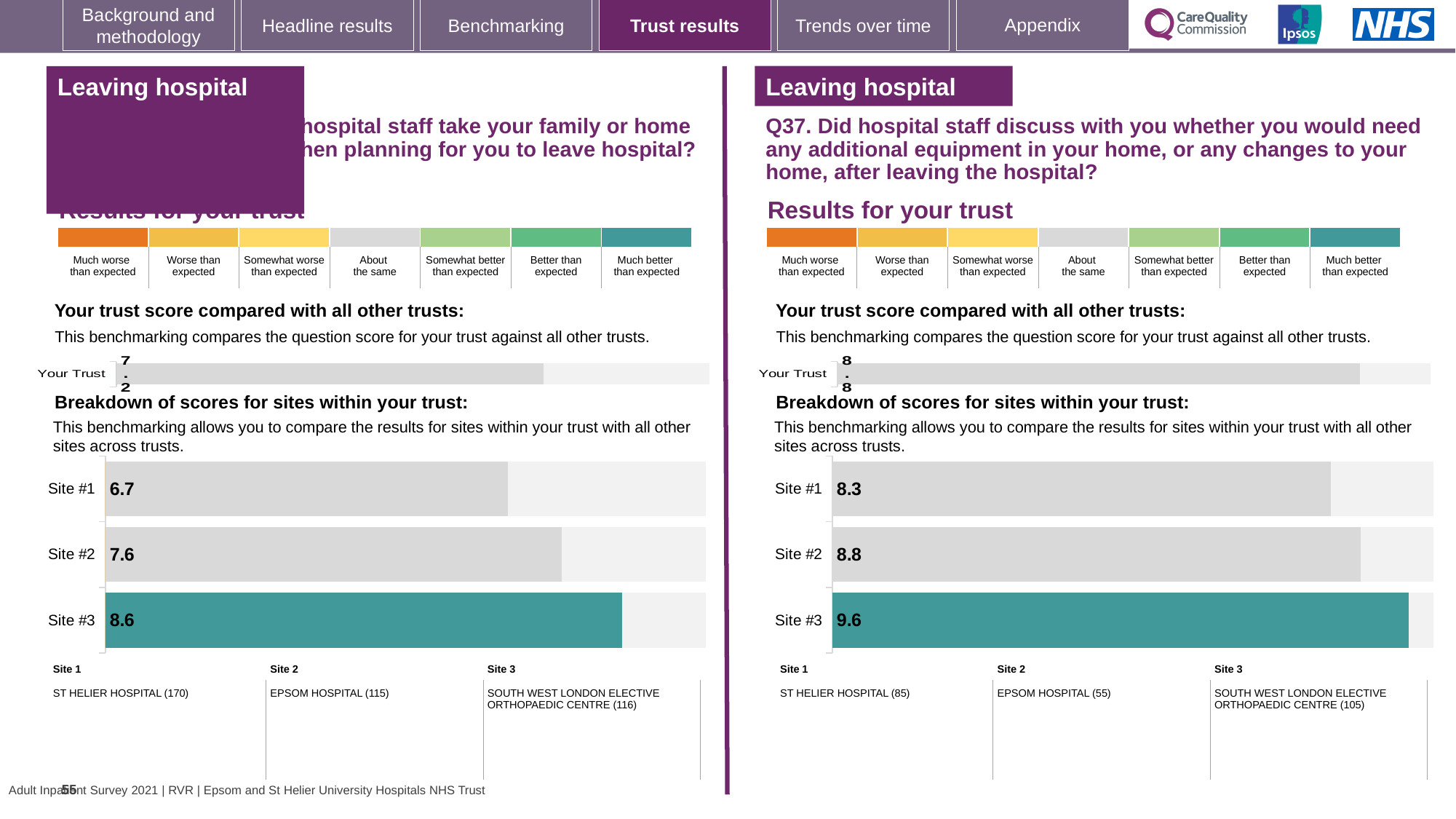
On the left-hand 'Your trust score compared with all other trusts' chart, what is the score for Your Trust? 7.2 What type of chart is the right-hand (Q37) site breakdown chart? Bar chart On the right-hand (Q37) 'Your trust score compared with all other trusts' chart, what is the score for Your Trust? 8.8 How many sites are shown on the left-hand site breakdown chart? 3 On the right-hand (Q37) site breakdown chart, which site has the highest score? Site #3 On the right-hand (Q37) site breakdown chart, which is larger: the score for Site #1 or Site #3? Site #3 On the left-hand site breakdown chart, which site has the lowest score? Site #1 On the left-hand site breakdown chart, what is the difference between the scores for Site #3 and Site #1? 1.9 On the left-hand site breakdown chart, do the scores rise or fall from Site #1 to Site #3? Rise On the right-hand (Q37) site breakdown chart, what is the score for Site #2? 8.8 On the right-hand (Q37) site breakdown chart, what is the difference between the scores for Site #3 and Site #2? 0.8 On the left-hand site breakdown chart, what is the score for Site #3? 8.6